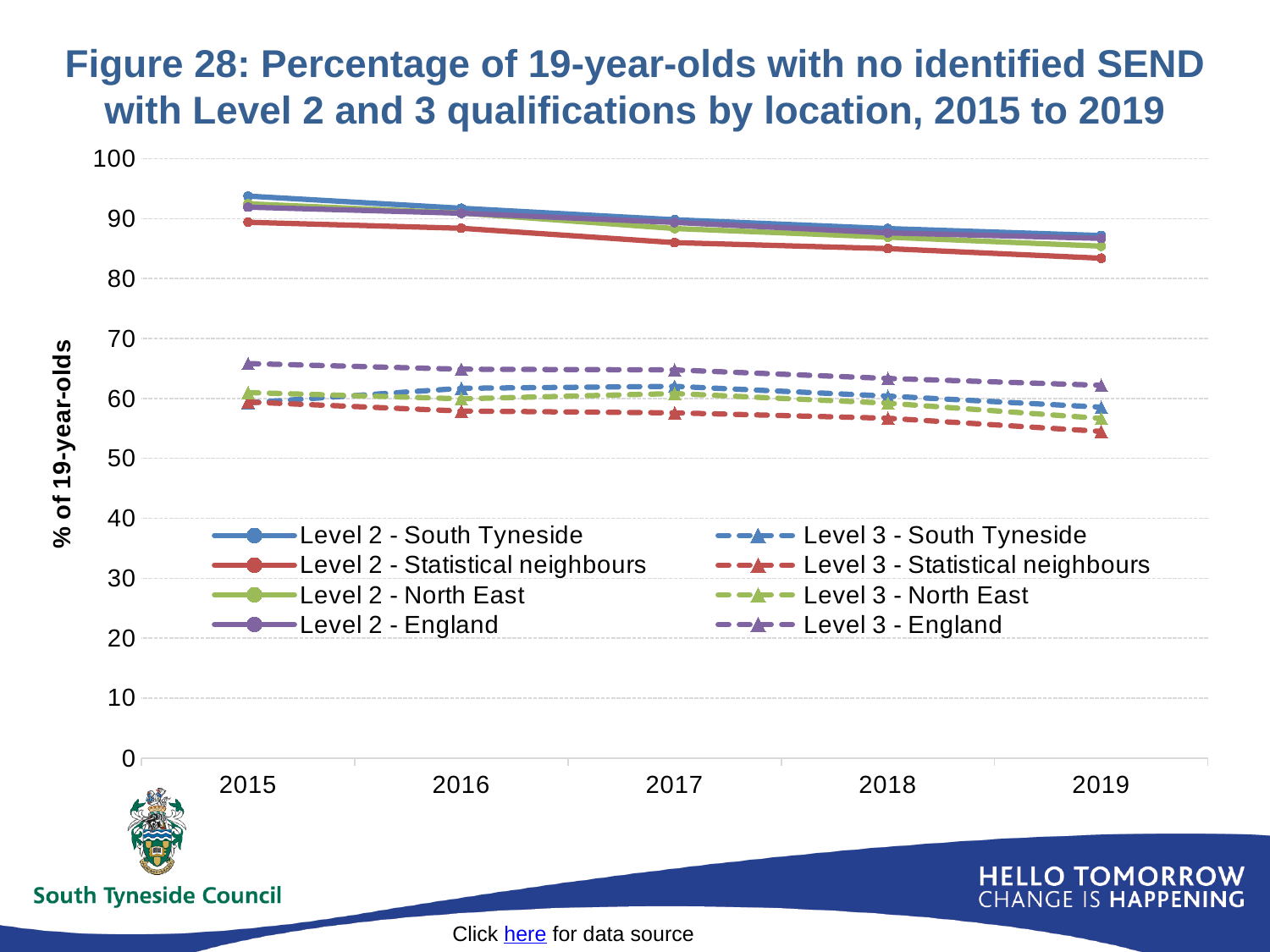
Does the Level 2 - Statistical neighbours line rise or fall from 2015 to 2019? Fall How many series does the legend list? 8 Which of the Level 3 series has the highest value in 2019? Level 3 - England What is the label on the y axis? % of 19-year-olds Is the value for Level 3 - England in 2015 greater or less than 60? greater Does the Level 3 - England line rise or fall from 2015 to 2019? Fall Is the value for Level 2 - South Tyneside in 2015 greater or less than 90? greater How many years are plotted along the x axis? 5 Is the value for Level 3 - Statistical neighbours in 2019 greater or less than 60? less Which of the Level 2 series has the lowest value in 2019? Level 2 - Statistical neighbours What kind of chart is shown on the slide? Line chart